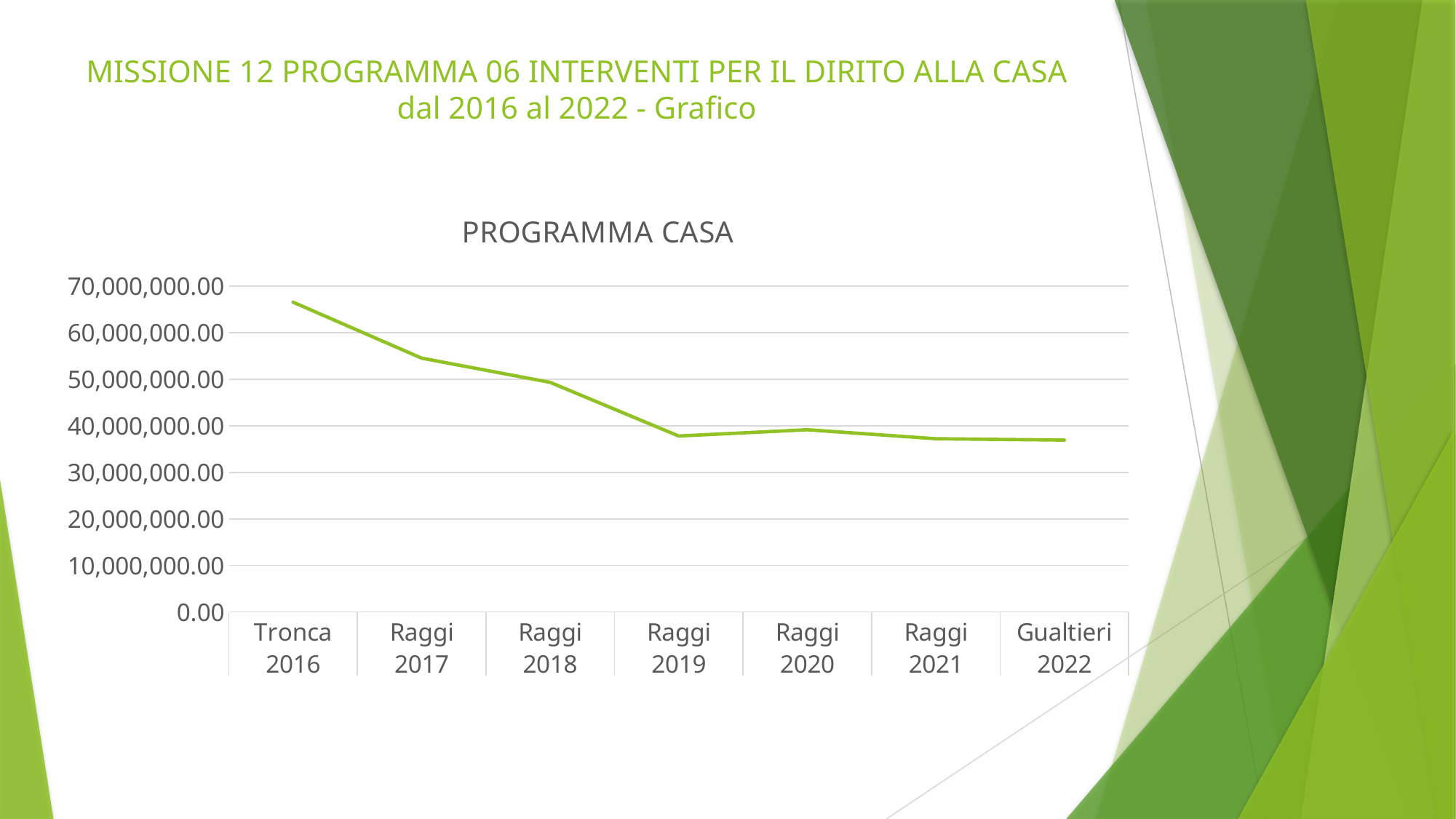
Is the value for Gualtieri 2022 greater or less than 40,000,000.00? less What is the title of the chart? PROGRAMMA CASA How many points are plotted along the x axis of the chart? 7 Which category has the highest value in the chart? Tronca 2016 Is the value for Raggi 2019 greater or less than 40,000,000.00? less Is the value for Tronca 2016 greater or less than 60,000,000.00? greater Do the values generally rise or fall from Tronca 2016 to Gualtieri 2022? fall What kind of chart is shown on the slide? line chart What colour is the line in the chart? green Which is larger, the value for Raggi 2018 or the value for Raggi 2019? Raggi 2018 Which is larger, the value for Tronca 2016 or the value for Raggi 2017? Tronca 2016